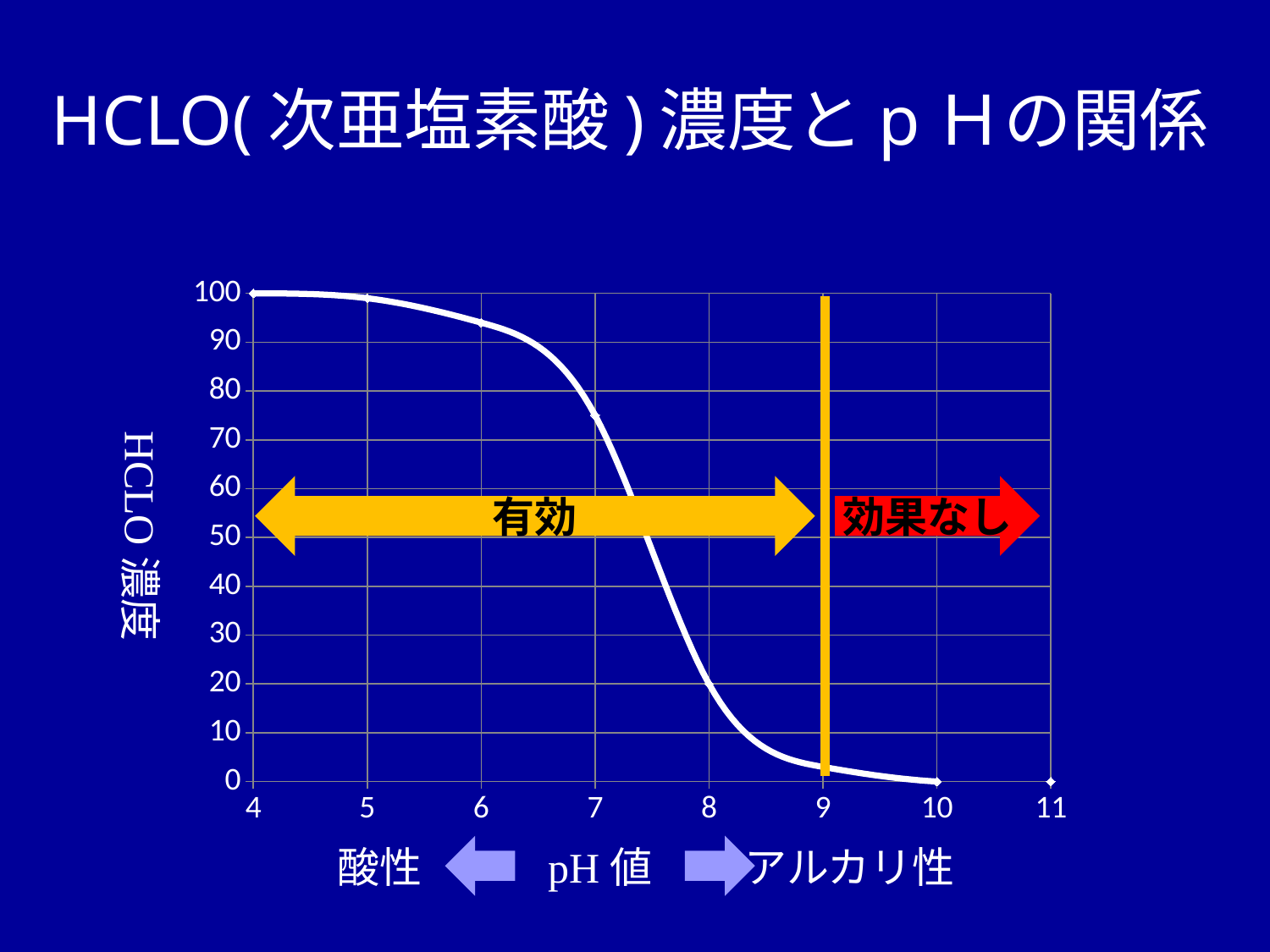
Is the HCLO concentration at pH 7 greater or less than 60? greater Is the HCLO concentration at pH 6 greater or less than 80? greater Is the HCLO concentration at pH 5 greater or less than 90? greater What is the HCLO concentration at pH 4? 100 What kind of chart is shown on the slide? line chart As pH increases along the x axis, does the HCLO concentration rise or fall? fall Which has the higher HCLO concentration, pH 6 or pH 8? pH 6 How many pH values are labelled on the x axis? 8 What is the label on the vertical axis of the chart? HCLO 濃度 At which pH value is the vertical orange line separating 有効 from 効果なし drawn? 9